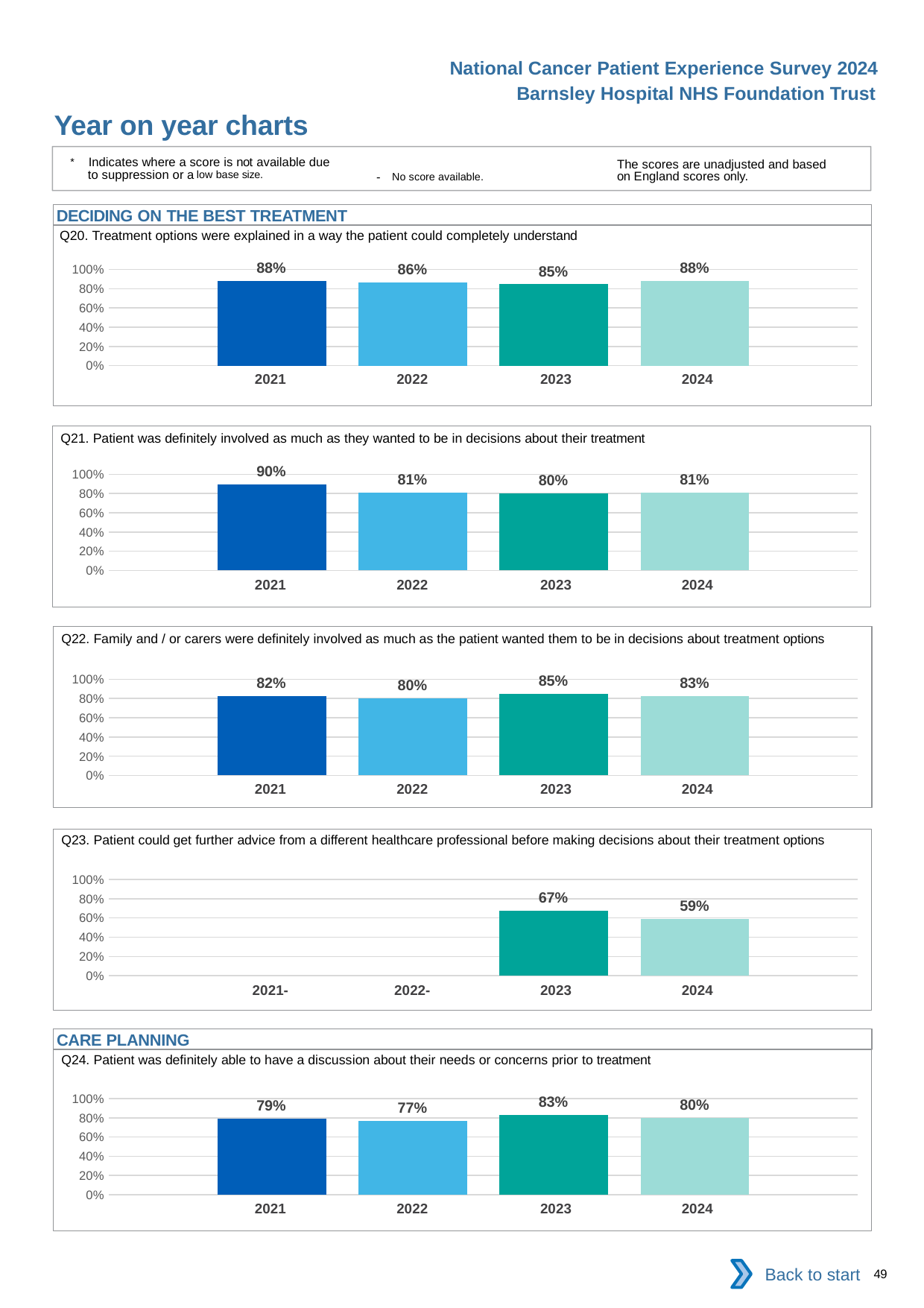
In the Q20 chart (Treatment options were explained in a way the patient could completely understand), what is the value for 2023? 85% In the Q22 chart (Family and / or carers were definitely involved as much as the patient wanted them to be in decisions about treatment options), which year has the lowest value? 2022 What kind of chart is used for Q20? Bar chart Which section heading appears above the Q24 chart? CARE PLANNING In the Q23 chart, is the value for 2024 greater or less than 60%? less In the Q21 chart (Patient was definitely involved as much as they wanted to be in decisions about their treatment), which year has the highest value? 2021 In the Q21 chart, what is the difference between the 2021 value and the 2024 value? 9 percentage points In the Q24 chart, what is the difference between the 2023 value and the 2022 value? 6 percentage points In the Q24 chart (Patient was definitely able to have a discussion about their needs or concerns prior to treatment), which is larger, the 2022 value or the 2023 value? 2023 In the Q23 chart, what is the value for 2023? 67% In the Q23 chart (Patient could get further advice from a different healthcare professional before making decisions about their treatment options), how many years have a bar plotted? 2 In the Q22 chart, what is the value for 2024? 83%